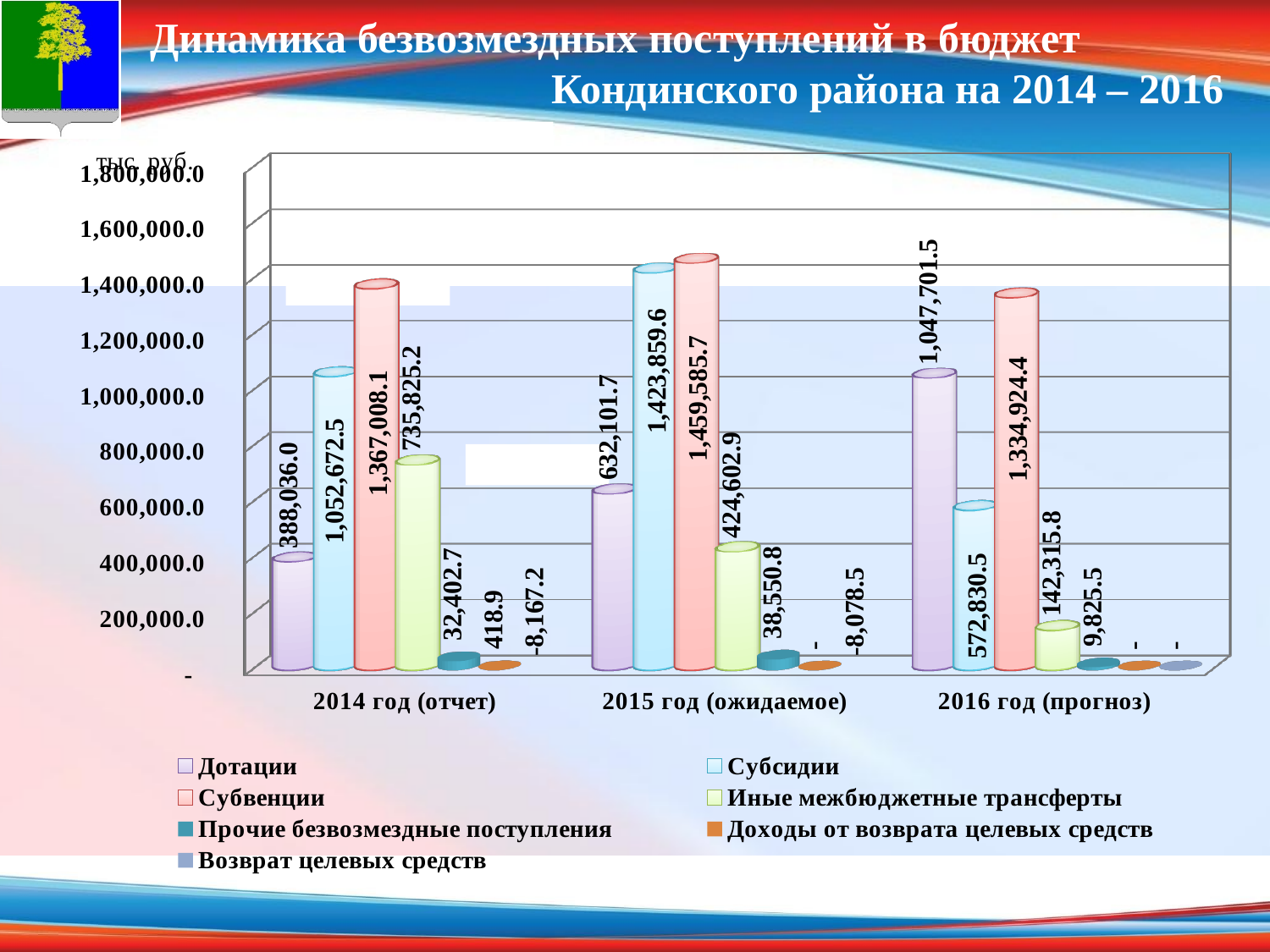
What is the value for Дотации in 2016 год (прогноз)? 1,047,701.5 Do the values for Иные межбюджетные трансферты rise or fall from 2014 to 2016? Fall Which is larger: Субсидии in 2014 год (отчет) or Субсидии in 2016 год (прогноз)? 2014 год (отчет) How many year categories are shown on the x axis? 3 What is the difference between the Субвенции values for 2015 год (ожидаемое) and 2014 год (отчет)? 92,577.6 In which year is the value for Дотации the highest? 2016 год (прогноз) What kind of chart is shown on the slide? Bar chart What is the value for Прочие безвозмездные поступления in 2016 год (прогноз)? 9,825.5 Which series has the highest value in 2015 год (ожидаемое)? Субвенции What is the value for Субвенции in 2014 год (отчет)? 1,367,008.1 What is the value for Субсидии in 2015 год (ожидаемое)? 1,423,859.6 How many series does the legend list? 7